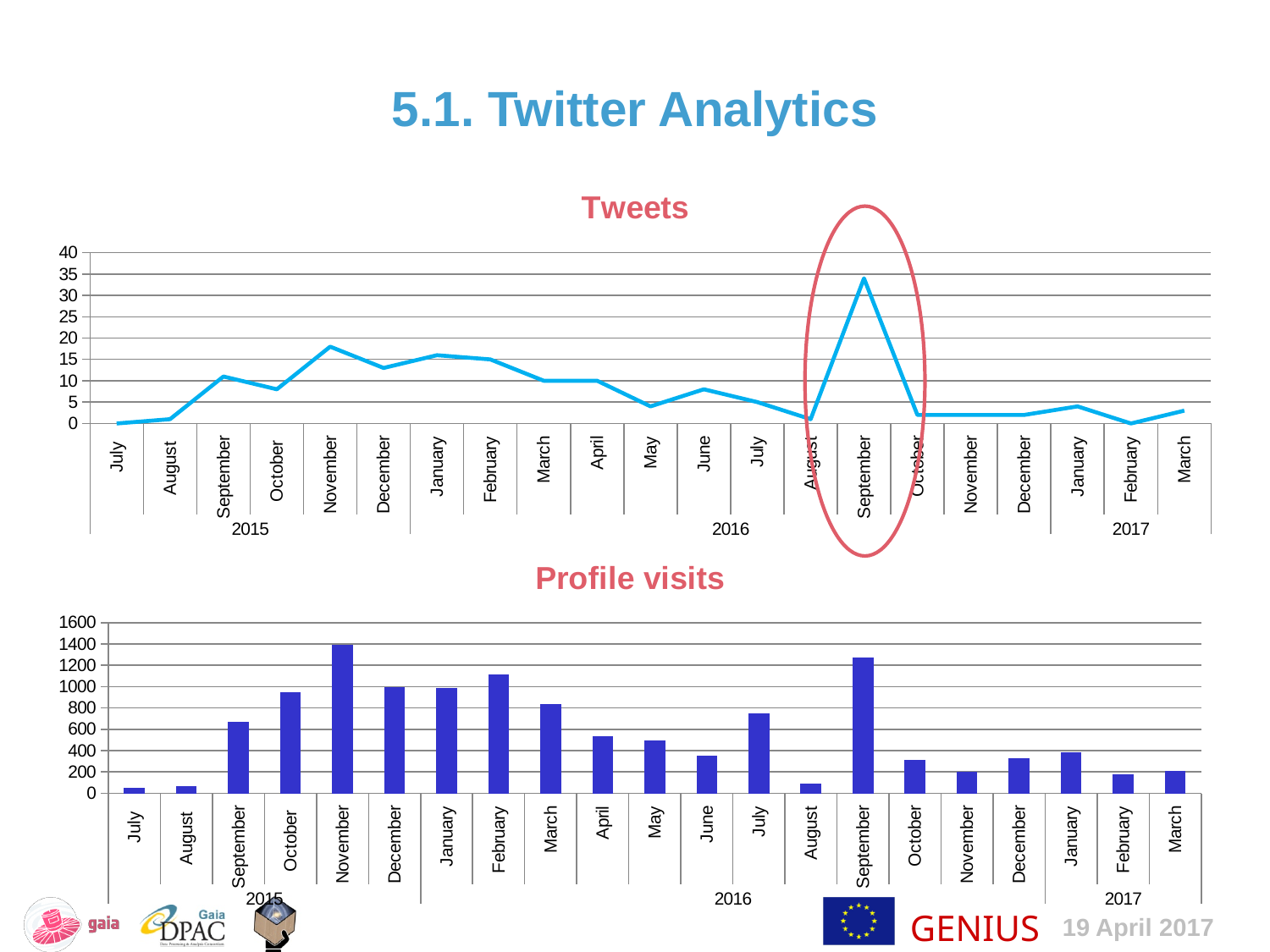
What kind of chart is the 'Profile visits' chart at the bottom of the slide? bar chart In the 'Profile visits' chart, is the value for August 2016 greater or less than 200? less How many months are plotted in the 'Profile visits' chart? 21 In the 'Profile visits' chart, which month has the highest value? November 2015 In the 'Profile visits' chart, which is larger, the value for November 2015 or the value for September 2016? November 2015 In the 'Tweets' chart, which month has the highest value? September 2016 In the 'Profile visits' chart, do the values rise or fall from September 2016 to November 2016? fall In the 'Tweets' chart, is the value for September 2016 greater or less than 30? greater In the 'Tweets' chart, which is larger, the value for November 2015 or the value for December 2015? November 2015 In the 'Profile visits' chart, is the value for November 2015 greater or less than 1200? greater What kind of chart is the 'Tweets' chart at the top of the slide? line chart